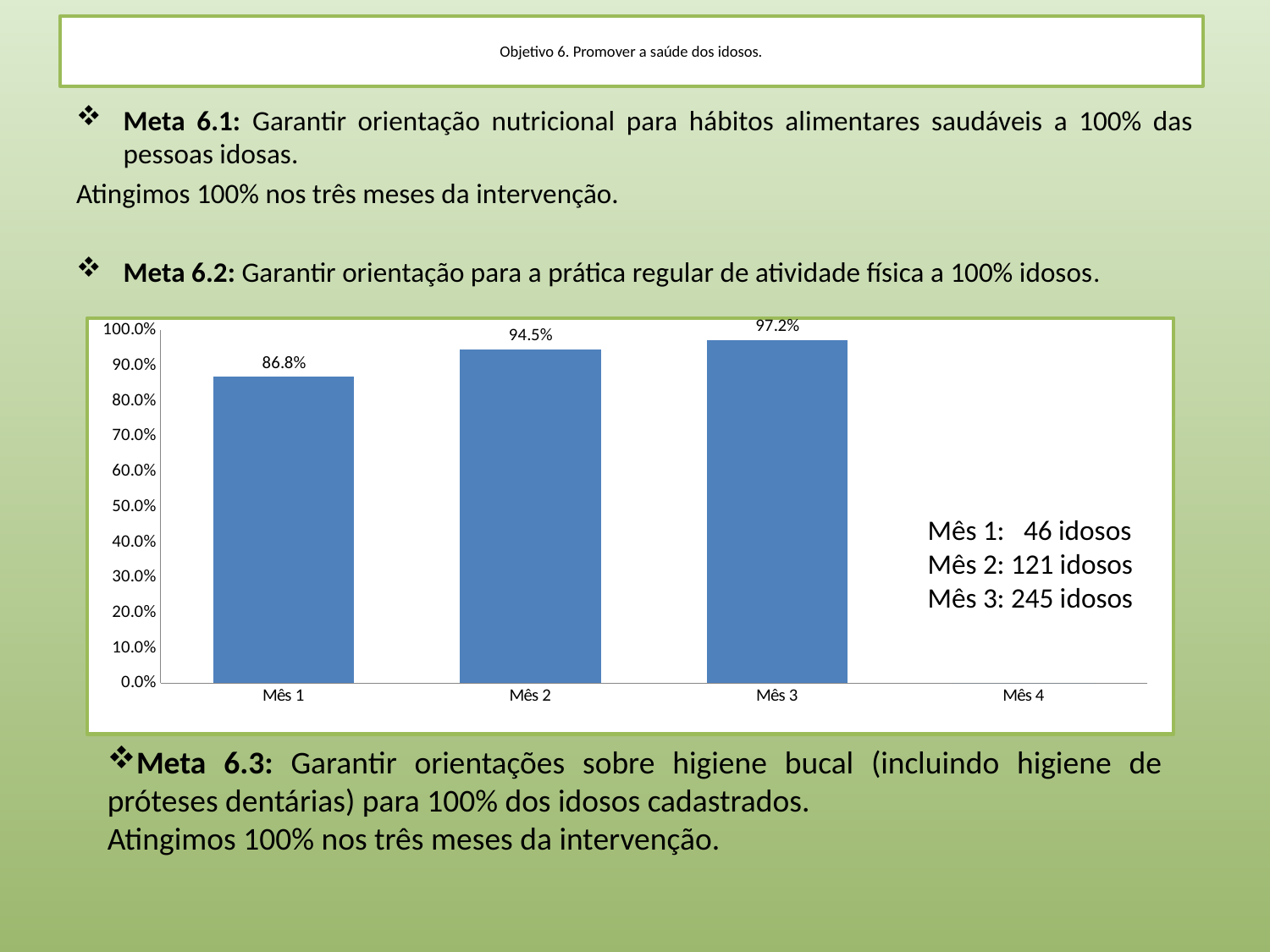
What is the difference between the values for Mês 3 and Mês 1? 10.4 percentage points Is the value for Mês 1 greater or less than 90.0%? less What is the value shown for Mês 2 in the bar chart? 94.5% What is the difference between the values for Mês 2 and Mês 1? 7.7 percentage points How many bars are plotted in the chart? 3 Which month with a plotted bar has the lowest value in the bar chart? Mês 1 What is the value shown for Mês 3 in the bar chart? 97.2% Which is larger, the value for Mês 2 or the value for Mês 3? Mês 3 Do the values rise or fall from Mês 1 to Mês 3? Rise What is the value shown for Mês 1 in the bar chart? 86.8% Which month has the highest value in the bar chart? Mês 3 What kind of chart is shown on the slide? Bar chart